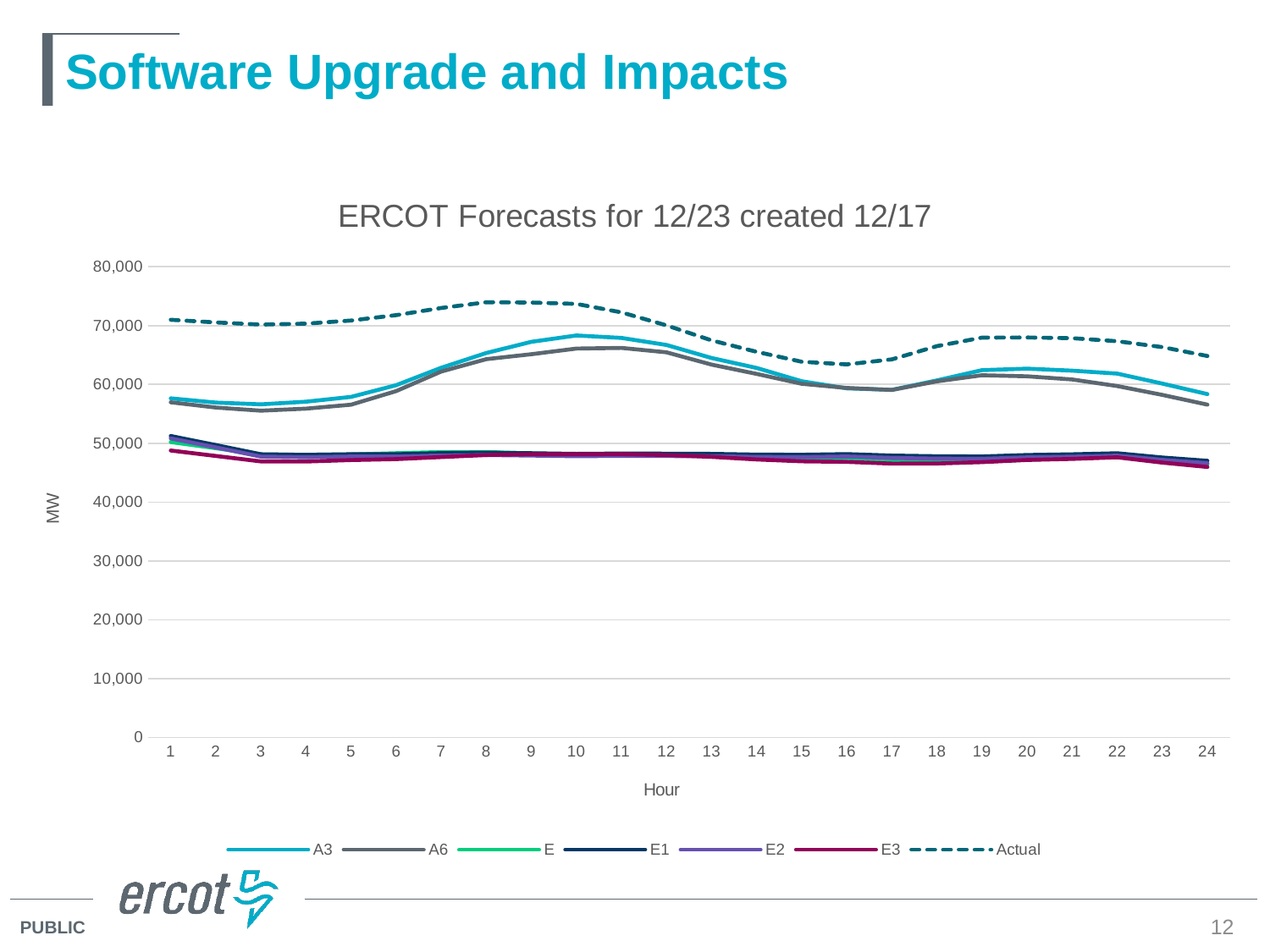
What is the label on the y axis? MW What is the title of the chart? ERCOT Forecasts for 12/23 created 12/17 Is the Actual value at hour 10 greater or less than 70,000? greater How many hours are plotted along the x axis? 24 Does the Actual series rise or fall from hour 10 to hour 16? fall Is the A6 value at hour 24 greater or less than 60,000? less What kind of chart is shown on the slide? line chart Is the E3 value at hour 3 greater or less than 50,000? less How many series does the legend list? 7 At hour 1, which is larger, the A3 value or the E3 value? A3 At hour 12, which series has the highest value? Actual